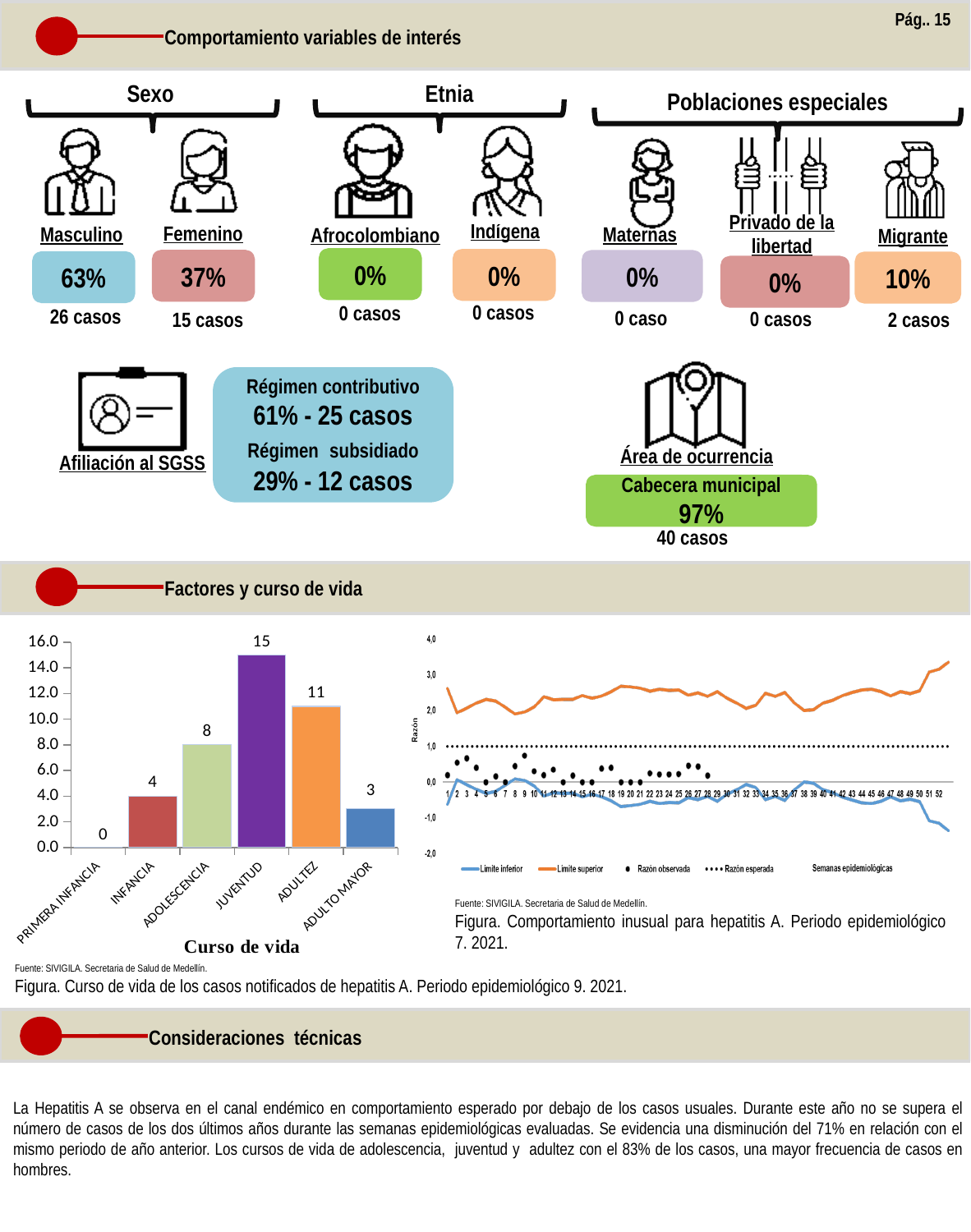
How many series does the legend of the line chart on the right ('Comportamiento inusual para hepatitis A') list? 4 In the bar chart 'Curso de vida', what is the difference between the values for JUVENTUD and ADULTEZ? 4 How many categories are shown on the x axis of the bar chart 'Curso de vida'? 6 In the bar chart 'Curso de vida', which category has the highest value? JUVENTUD In the line chart on the right ('Comportamiento inusual para hepatitis A'), is the value of Límite superior at week 52 greater or less than 3,0? greater In the bar chart 'Curso de vida', what is the value for PRIMERA INFANCIA? 0 In the bar chart 'Curso de vida', which category has the lowest value? PRIMERA INFANCIA In the bar chart 'Curso de vida', what is the total of the values for INFANCIA, ADOLESCENCIA and ADULTO MAYOR? 15 What kind of chart is the 'Curso de vida' chart on the left? Bar chart In the bar chart 'Curso de vida', what is the value for ADULTEZ? 11 In the bar chart 'Curso de vida', which is larger, the value for ADOLESCENCIA or the value for ADULTO MAYOR? ADOLESCENCIA In the bar chart 'Curso de vida', what is the value for JUVENTUD? 15